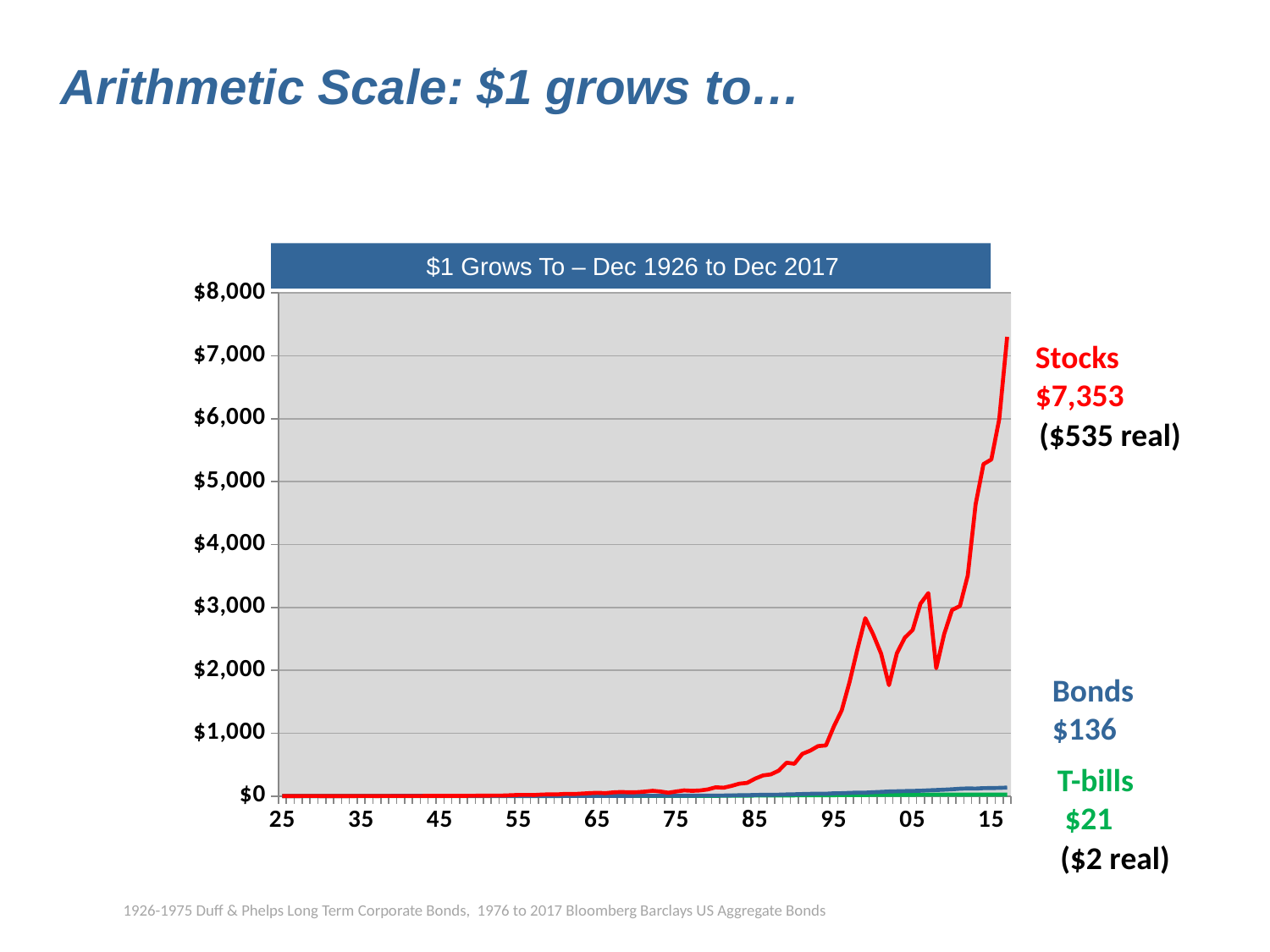
Which series has the lowest ending value? T-bills Which ending value is larger, Bonds or T-bills? Bonds What is the title of the chart? $1 Grows To – Dec 1926 to Dec 2017 Is the Stocks value at the year 05 tick greater or less than $2,000? greater According to the chart labels, what does $1 in T-bills grow to by Dec 2017? $21 What is the real (inflation-adjusted) ending value shown for Stocks? $535 real Which series has the highest ending value? Stocks What kind of chart is shown on the slide? line chart According to the chart labels, what does $1 in Stocks grow to by Dec 2017? $7,353 According to the chart labels, what does $1 in Bonds grow to by Dec 2017? $136 How many series are plotted on the chart? 3 What is the difference between the ending values of Stocks and Bonds? $7,217